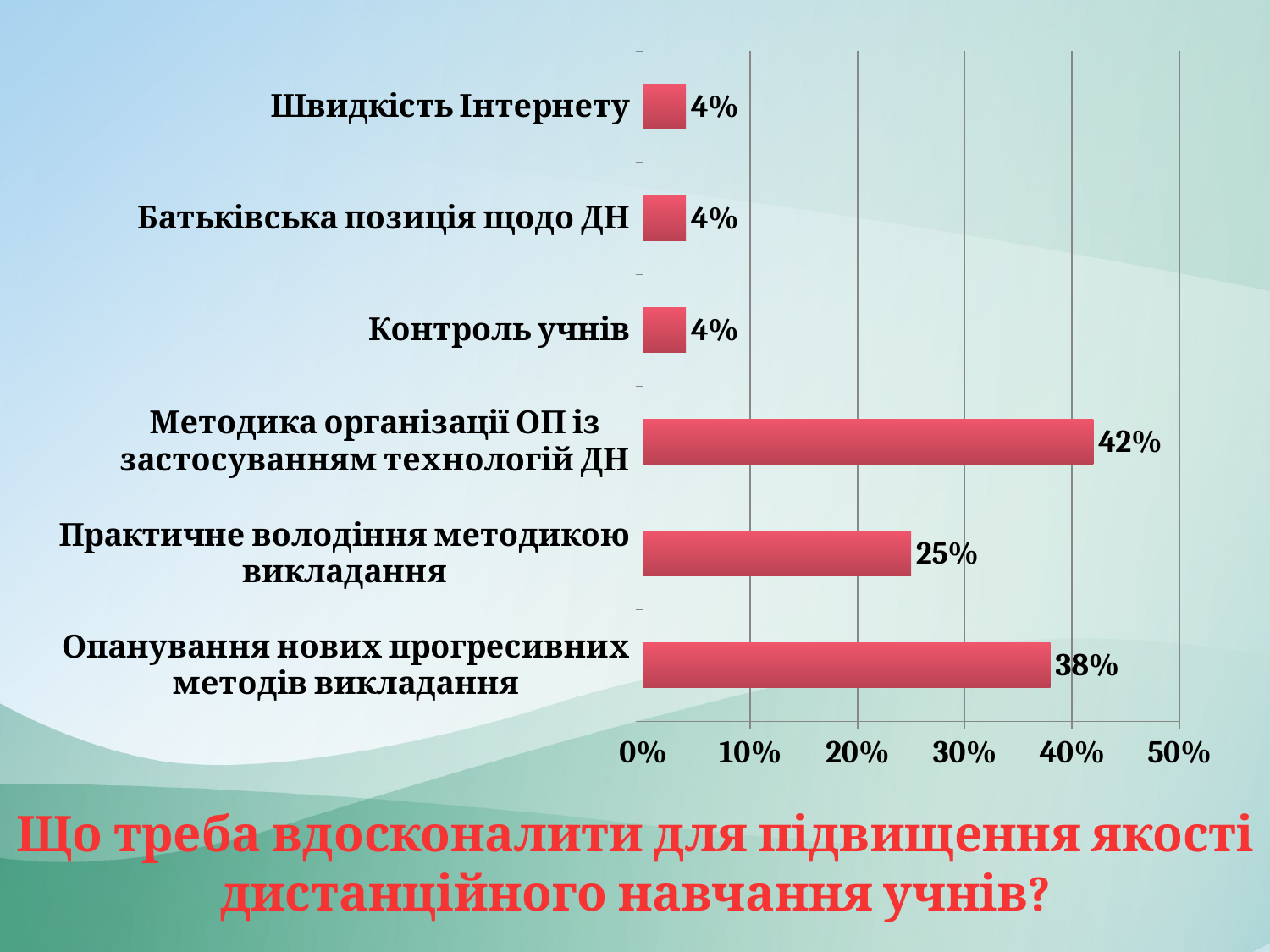
What kind of chart is shown on the slide? bar chart What is the value for "Практичне володіння методикою викладання"? 25% What is the value for "Швидкість Інтернету"? 4% Is the value for "Методика організації ОП із застосуванням технологій ДН" greater or less than 40%? greater What is the value for "Опанування нових прогресивних методів викладання"? 38% What is the difference between the values for "Опанування нових прогресивних методів викладання" and "Практичне володіння методикою викладання"? 13% Which category has the highest value? Методика організації ОП із застосуванням технологій ДН What is the value for "Методика організації ОП із застосуванням технологій ДН"? 42% What is the maximum value shown on the horizontal axis? 50% Which is larger: the value for "Практичне володіння методикою викладання" or the value for "Опанування нових прогресивних методів викладання"? Опанування нових прогресивних методів викладання What is the difference between the values for "Методика організації ОП із застосуванням технологій ДН" and "Опанування нових прогресивних методів викладання"? 4% How many categories are shown in the chart? 6